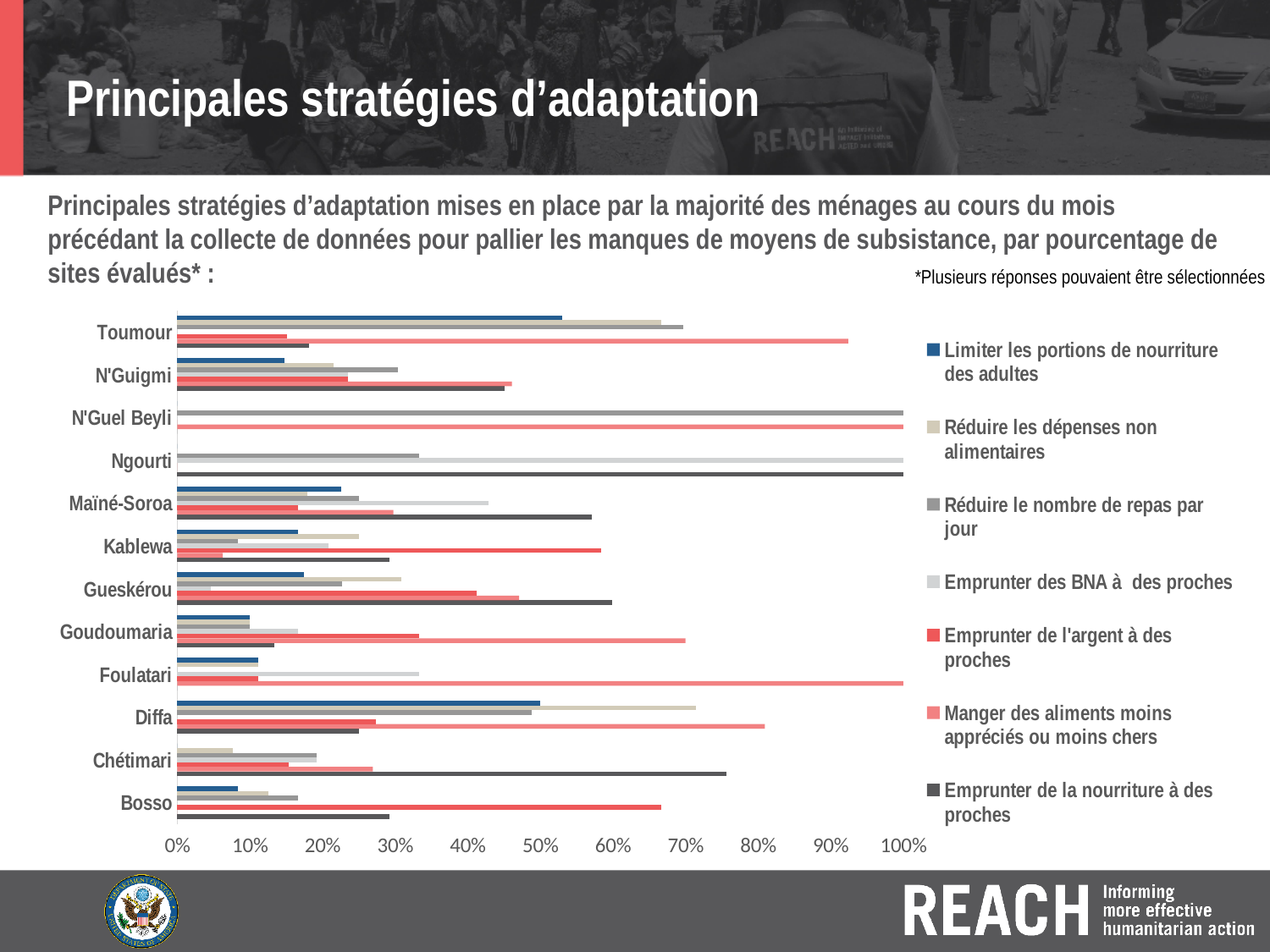
Which site has the highest value for 'Emprunter de la nourriture à des proches'? Ngourti Is the value for 'Manger des aliments moins appréciés ou moins chers' at Toumour greater or less than 90%? greater What is the value for 'Emprunter de la nourriture à des proches' at Ngourti? 100% Is the value for 'Emprunter de la nourriture à des proches' at Chétimari greater or less than 70%? greater What is the value for 'Réduire le nombre de repas par jour' at N'Guel Beyli? 100% Which is larger at Diffa: 'Limiter les portions de nourriture des adultes' or 'Emprunter de l'argent à des proches'? Limiter les portions de nourriture des adultes How many sites (categories) are listed on the vertical axis of the chart? 12 What is the value for 'Manger des aliments moins appréciés ou moins chers' at Foulatari? 100% Which legend entry is shown in dark blue? Limiter les portions de nourriture des adultes How many series does the chart legend list? 7 What kind of chart is shown on the slide? bar chart Is the value for 'Emprunter de l'argent à des proches' at Kablewa greater or less than 10%? greater